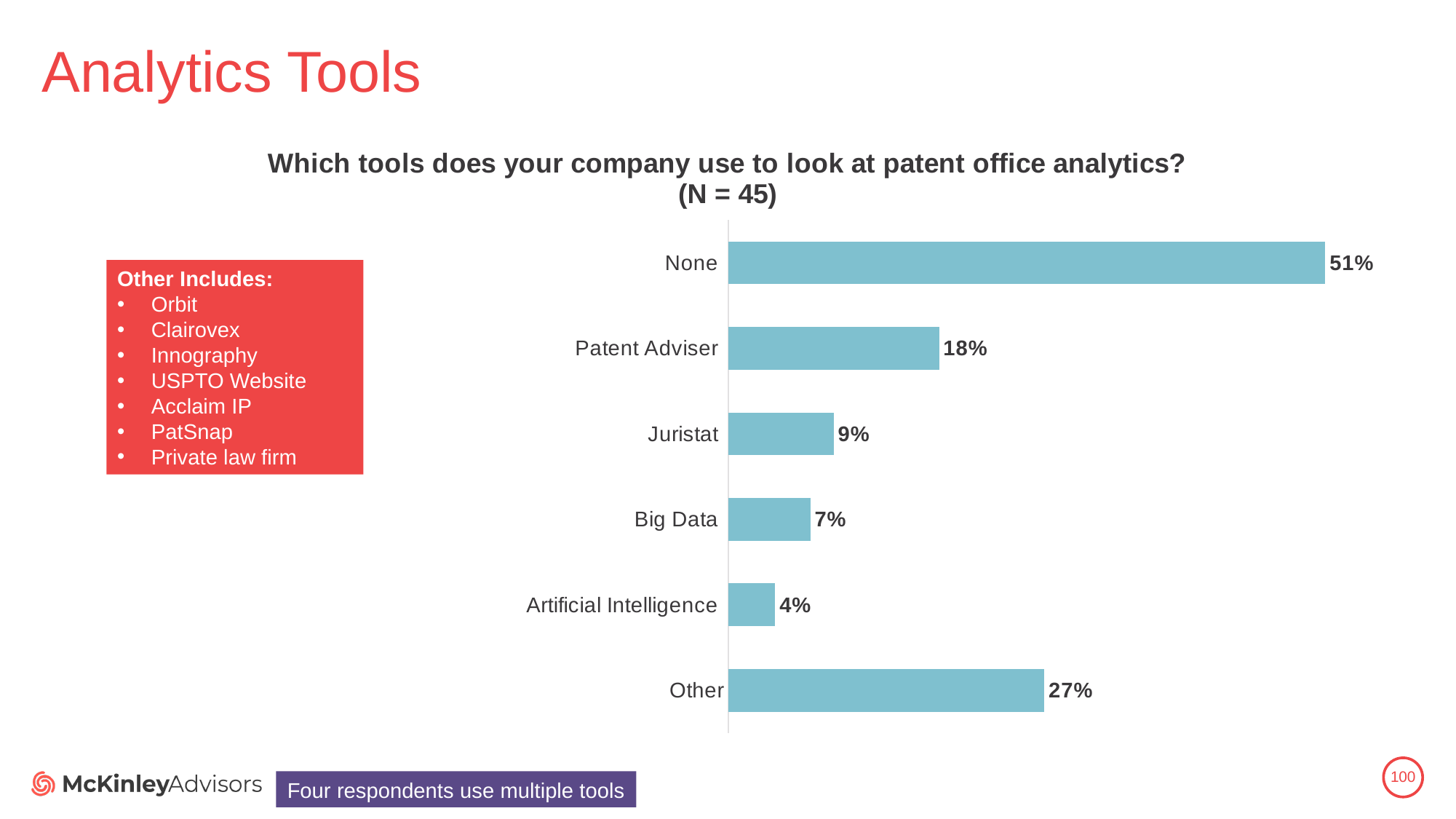
Which category has the lowest value in the chart? Artificial Intelligence What is the difference between the values for Other and Patent Adviser? 9% What is the value for Artificial Intelligence? 4% What percentage is shown for Juristat? 9% What is the value shown for Patent Adviser? 18% What is the difference between the values for None and Other? 24% Which category has the highest value in the chart? None Which is larger, the value for Big Data or the value for Juristat? Juristat What is the sample size (N) stated in the chart title? 45 How many categories are shown in the chart? 6 What kind of chart is shown on the slide? Bar chart What percentage of respondents use no tools (None) to look at patent office analytics? 51%